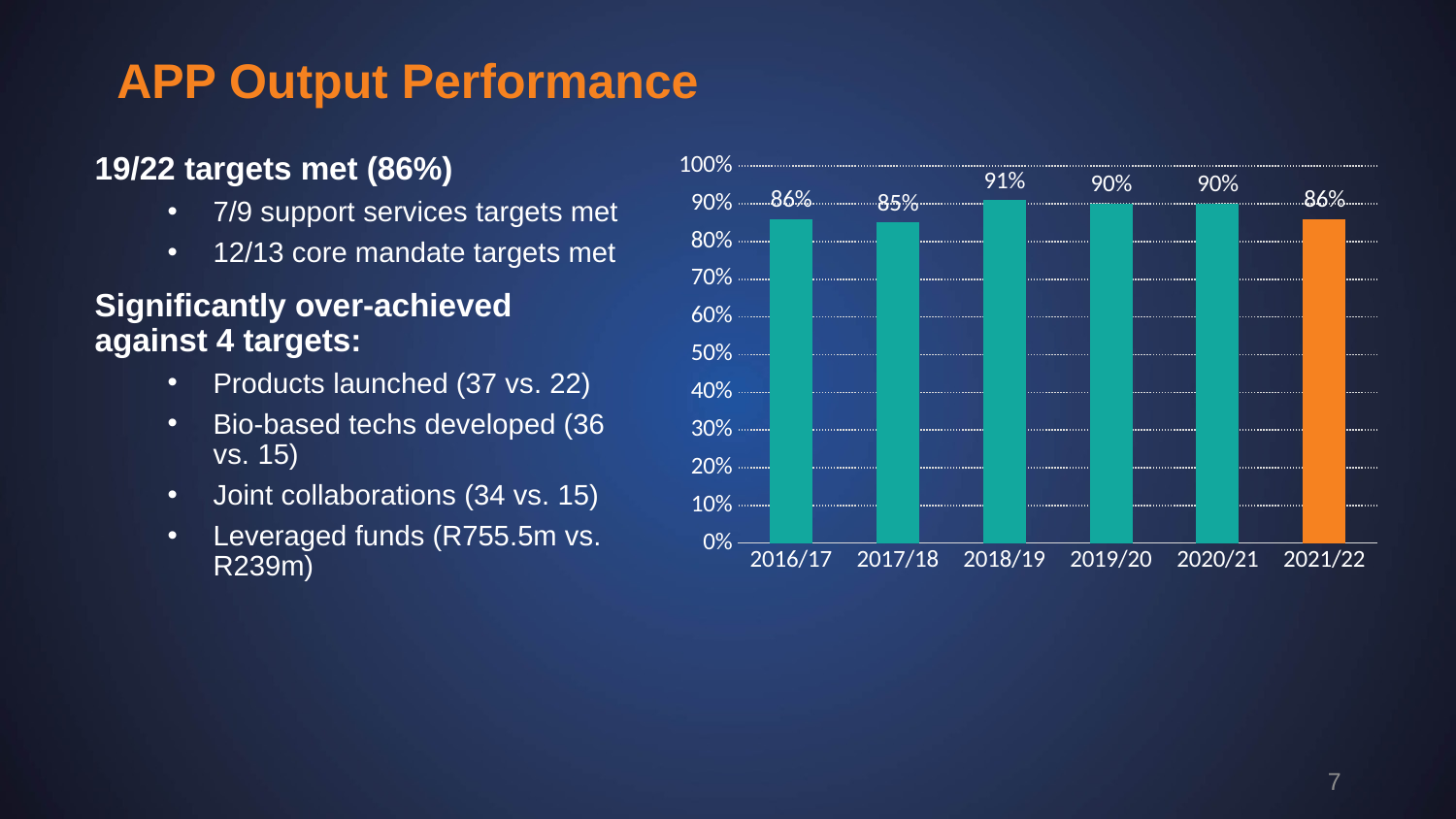
Is the value for 2020/21 greater or less than 50%? greater What is the difference between the values for 2018/19 and 2017/18? 6% Which year has the highest value? 2018/19 What is the value for 2019/20? 90% How many years are shown on the x axis? 6 What is the value for 2018/19? 91% What is the value for 2021/22? 86% Which bar is shown in a different colour (orange) from the others? 2021/22 Which year has the lowest value? 2017/18 Which is larger, the value for 2019/20 or the value for 2017/18? 2019/20 What kind of chart is shown? bar chart What is the value for 2016/17? 86%